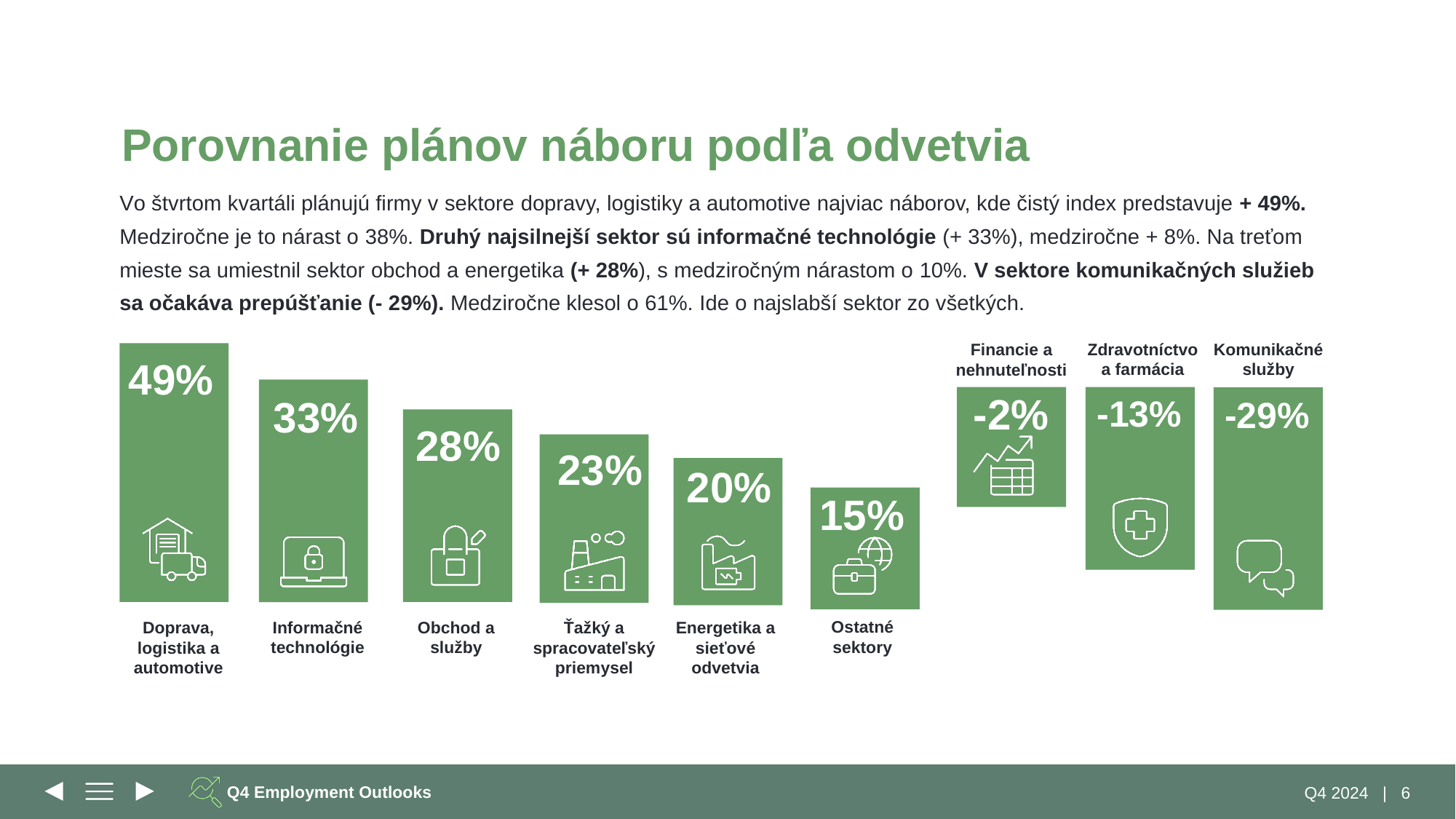
What is the value for Doprava, logistika a automotive? 49% What is the difference between the values for Doprava, logistika a automotive and Komunikačné služby? 78% Which sector has the highest value? Doprava, logistika a automotive What is the difference between the values for Informačné technológie and Obchod a služby? 5% What is the value for Ostatné sektory? 15% Do the values rise or fall from left to right across the chart? Fall Which is larger, the value for Ťažký a spracovateľský priemysel or the value for Energetika a sieťové odvetvia? Ťažký a spracovateľský priemysel What is the value for Financie a nehnuteľnosti? -2% What is the value for Zdravotníctvo a farmácia? -13% What kind of chart is shown on the slide? Bar chart How many sectors are shown in the chart? 9 Which sector has the lowest value? Komunikačné služby